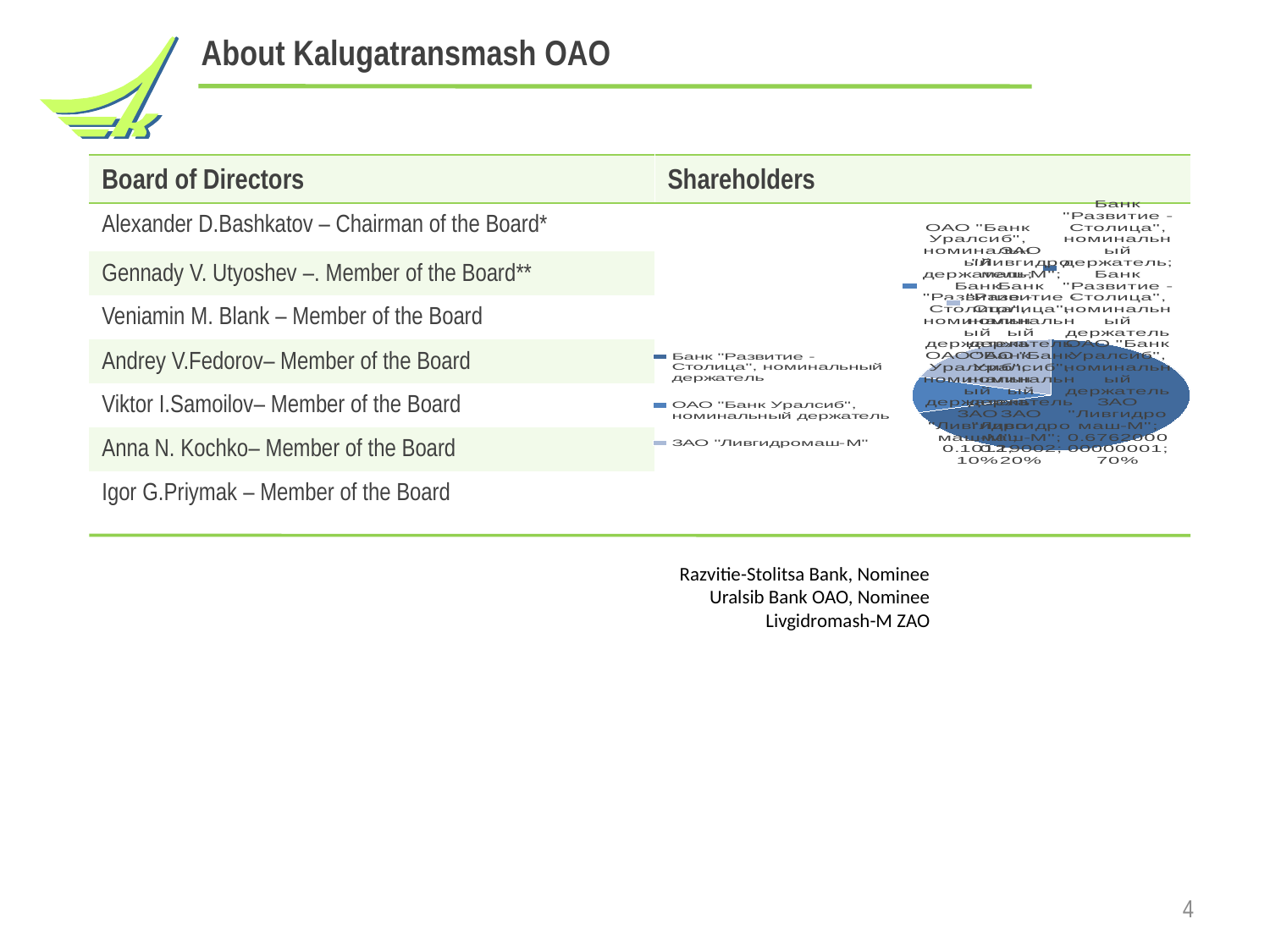
Which legend entry of the Shareholders pie chart is listed last? ЗАО "Ливгидромаш-М" How many slices does the Shareholders pie chart have? 3 Under which heading on the slide does the pie chart appear? Shareholders What is the difference between the largest and smallest percentages shown on the Shareholders pie chart? 60% What is the largest percentage shown on the Shareholders pie chart? 70% What is the smallest percentage shown on the Shareholders pie chart? 10% What kind of chart is shown under the Shareholders heading? pie chart Which is larger on the Shareholders pie chart, the 20% slice or the 70% slice? the 70% slice Is the largest slice of the Shareholders pie chart greater or less than 50%? greater How many entries does the legend of the Shareholders pie chart list? 3